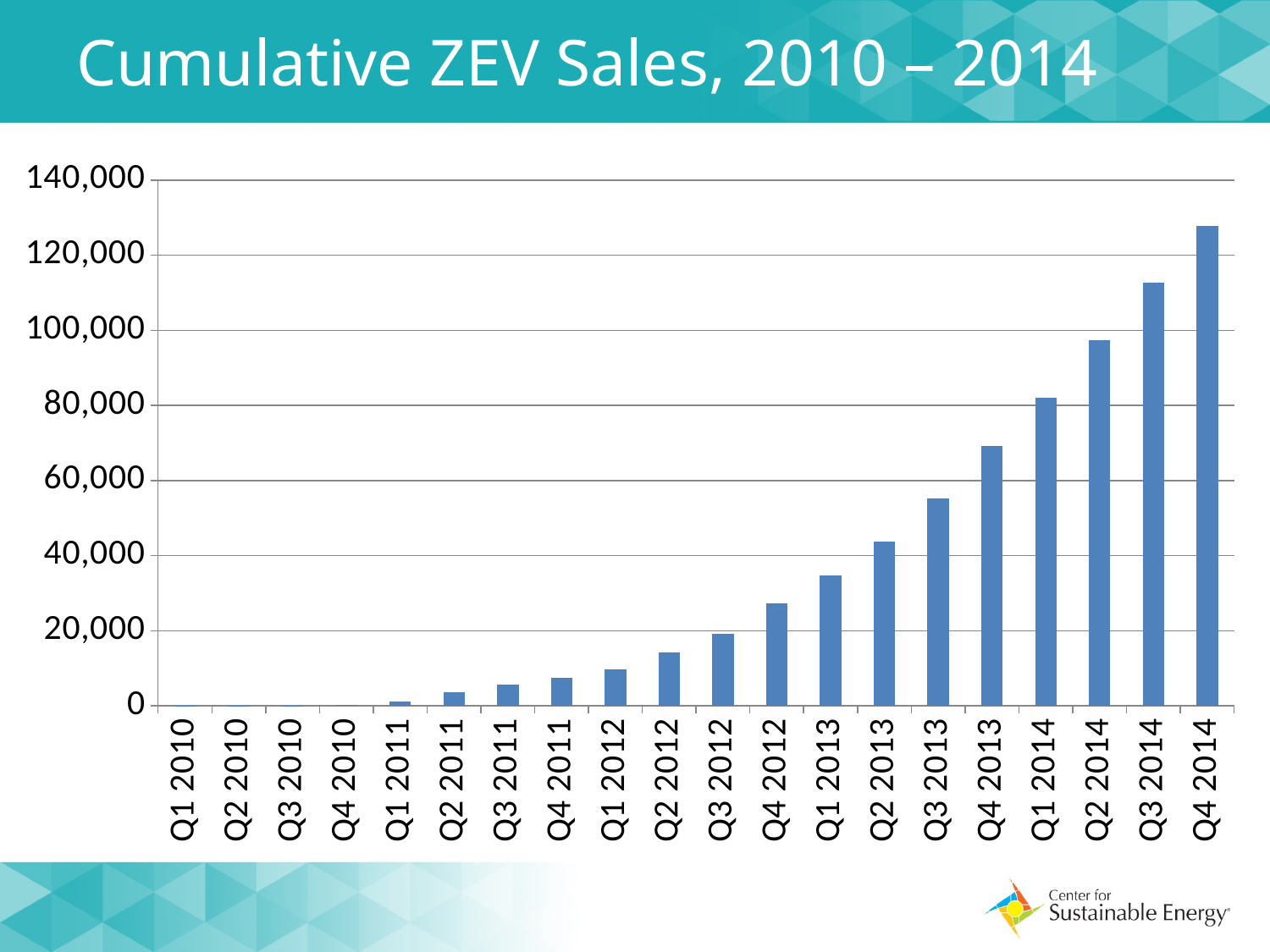
What is the title of the chart? Cumulative ZEV Sales, 2010 – 2014 What is the highest value shown on the y axis? 140,000 How many quarters are shown on the x axis? 20 Is the value for Q2 2012 greater or less than 20,000? less Is the value for Q3 2014 greater or less than 100,000? greater What kind of chart is shown on the slide? bar chart Is the value for Q1 2013 greater or less than 40,000? less Do cumulative ZEV sales rise or fall from Q1 2010 to Q4 2014? rise Which quarter has the highest cumulative ZEV sales? Q4 2014 Which is larger, the value for Q4 2014 or the value for Q1 2014? Q4 2014